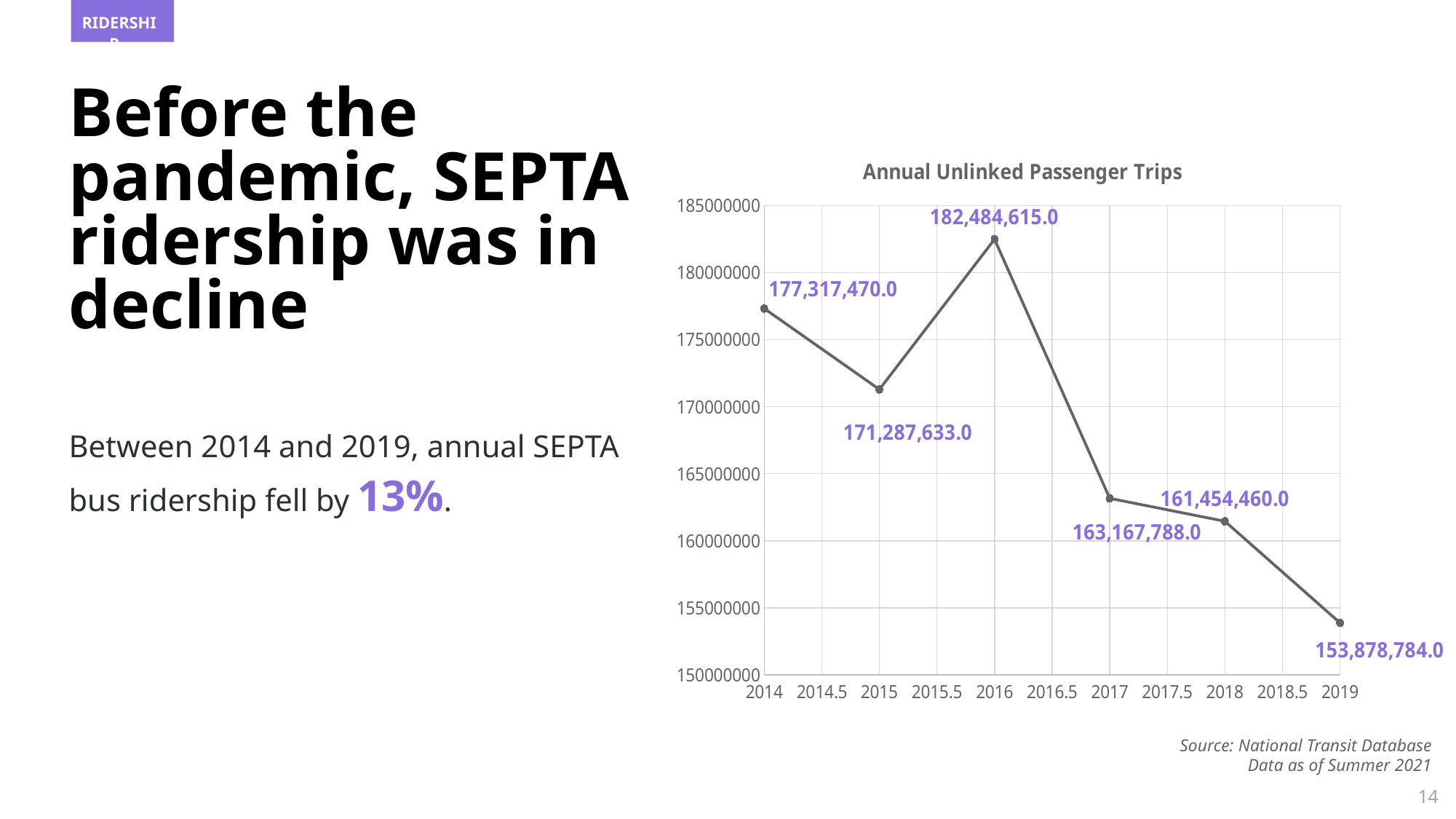
What is the difference between the 2016 and 2015 values in the Annual Unlinked Passenger Trips chart? 11,196,982.0 Do the values in the Annual Unlinked Passenger Trips chart rise or fall from 2016 to 2019? fall Is the value for 2018 in the Annual Unlinked Passenger Trips chart greater or less than 165000000? less How many data points are plotted in the Annual Unlinked Passenger Trips chart? 6 Which year has the highest value in the Annual Unlinked Passenger Trips chart? 2016 Which year has the larger value in the Annual Unlinked Passenger Trips chart, 2015 or 2017? 2015 What is the value for 2017 in the Annual Unlinked Passenger Trips chart? 163,167,788.0 What is the value for 2014 in the Annual Unlinked Passenger Trips chart? 177,317,470.0 What is the difference between the 2014 and 2019 values in the Annual Unlinked Passenger Trips chart? 23,438,686.0 What kind of chart is the Annual Unlinked Passenger Trips chart? line chart Which year has the lowest value in the Annual Unlinked Passenger Trips chart? 2019 What is the value for 2019 in the Annual Unlinked Passenger Trips chart? 153,878,784.0